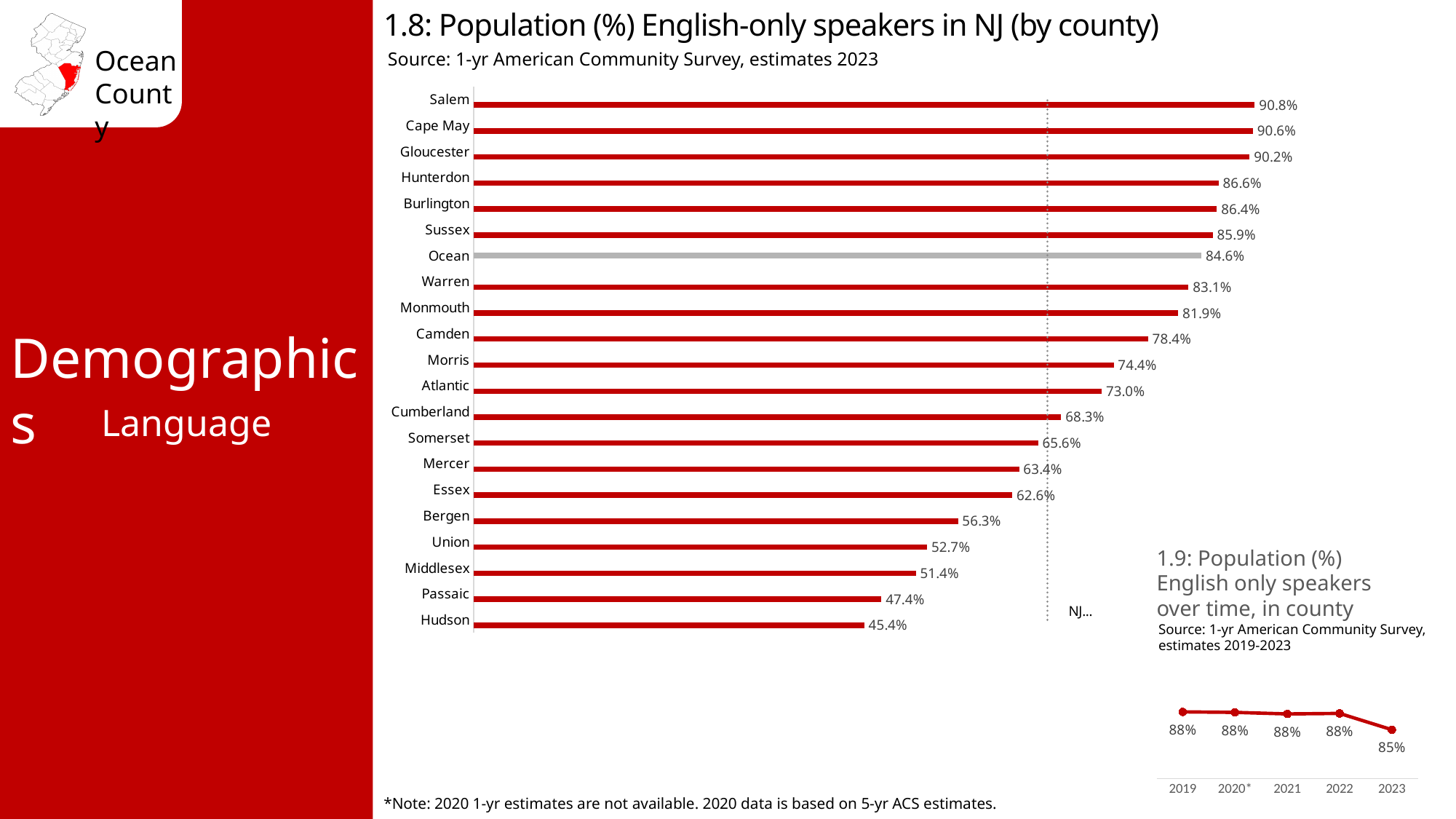
In chart 1.9, do the values rise or fall from 2022 to 2023? Fall In chart 1.9, what is the value for 2023? 85% In chart 1.8, how many counties are shown? 21 What kind of chart is chart 1.8? Bar chart In chart 1.9, how many years are plotted? 5 In chart 1.8, which county's bar is coloured grey instead of red? Ocean In chart 1.8, which county has the lowest percentage of English-only speakers? Hudson In chart 1.8, what is the value for Hudson county? 45.4% In chart 1.8, which has a higher value, Bergen or Camden? Camden In chart 1.8, what is the difference between the values for Salem and Hudson? 45.4% In chart 1.8, which county has the highest percentage of English-only speakers? Salem In chart 1.8, what is the value for Ocean county? 84.6%